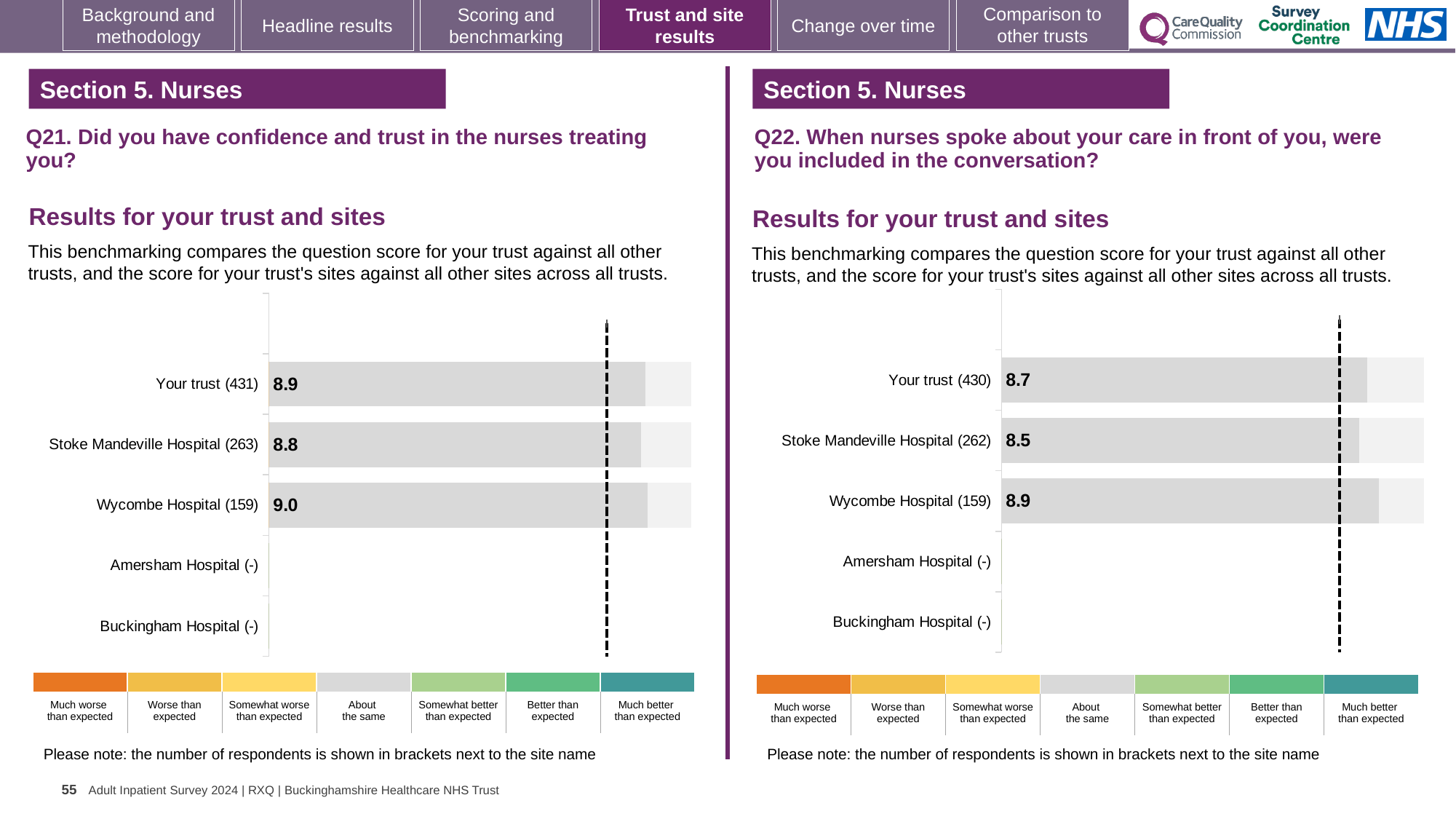
On the Q22 chart (right), how many respondents are shown in brackets for Wycombe Hospital? 159 On the Q21 chart (left), what is the score for Your trust (431)? 8.9 On the Q21 chart (left), how many sites or trusts are listed on the vertical axis? 5 On the Q22 chart (right), which site or trust has the lowest score among those with a plotted value? Stoke Mandeville Hospital (262) On the Q22 chart (right), what is the score for Your trust (430)? 8.7 What type of chart is used on the Q21 chart (left)? Bar chart On the Q22 chart (right), what is the score for Stoke Mandeville Hospital (262)? 8.5 On the Q21 chart (left), what is the score for Wycombe Hospital (159)? 9.0 On the Q21 chart (left), which has the higher score: Your trust or Stoke Mandeville Hospital? Your trust On the Q21 chart (left), which site or trust has the highest score? Wycombe Hospital (159) On the Q22 chart (right), how many sites have a plotted score (not shown as '-')? 3 On the Q22 chart (right), what is the difference between the scores for Wycombe Hospital and Stoke Mandeville Hospital? 0.4